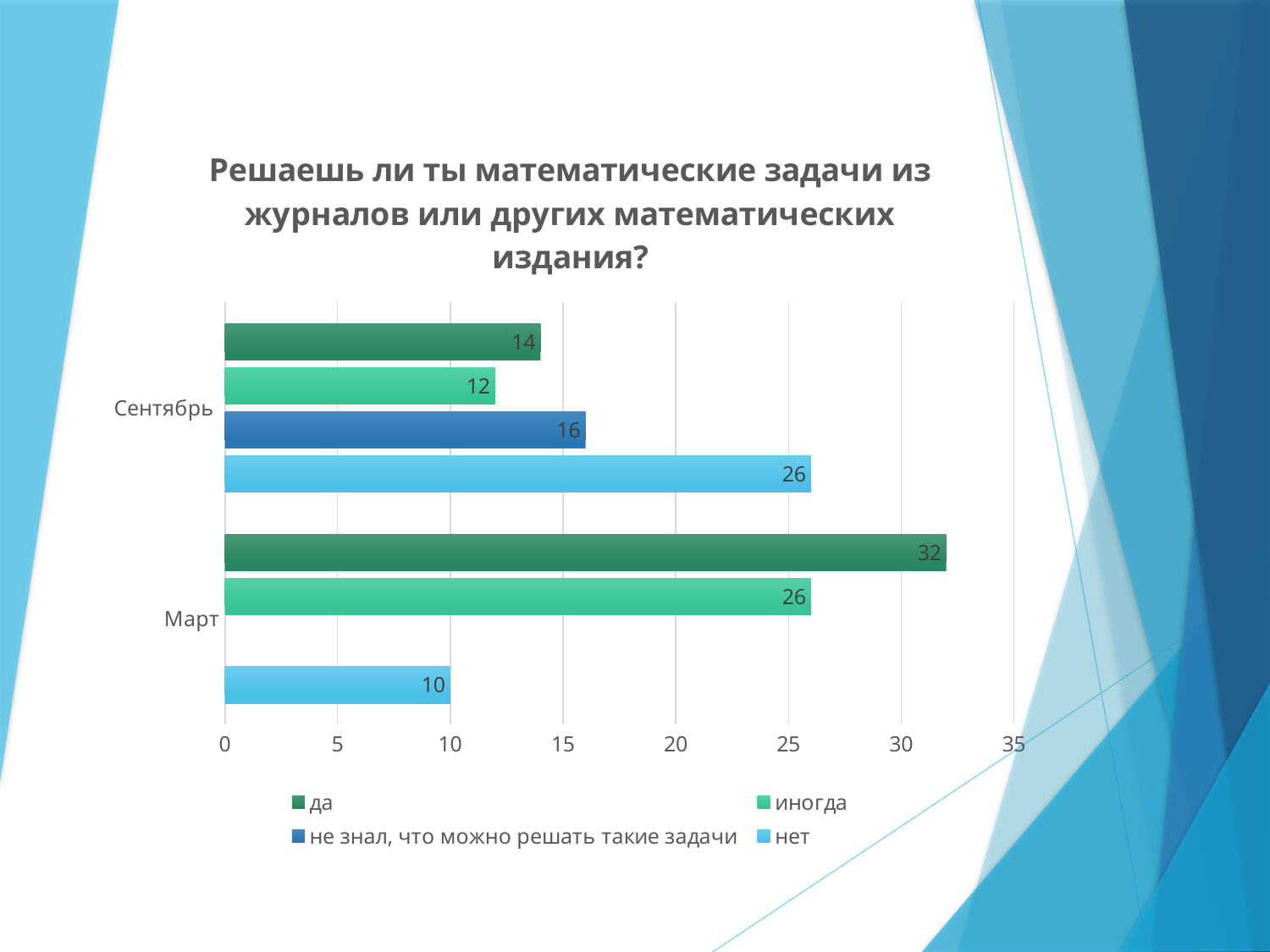
What is the value for "нет" in Март? 10 How many series does the legend list? 4 What type of chart is shown on the slide? bar chart What is the value for "не знал, что можно решать такие задачи" in Сентябрь? 16 What is the value for "да" in Сентябрь? 14 Which series has the lowest value in Сентябрь? иногда What is the difference between the "да" values for Март and Сентябрь? 18 Which is larger: the "нет" value in Сентябрь or the "нет" value in Март? Сентябрь Which series has the highest value in Март? да What is the value for "иногда" in Март? 26 What is the title of the chart? Решаешь ли ты математические задачи из журналов или других математических издания? How many categories are shown on the vertical axis? 2